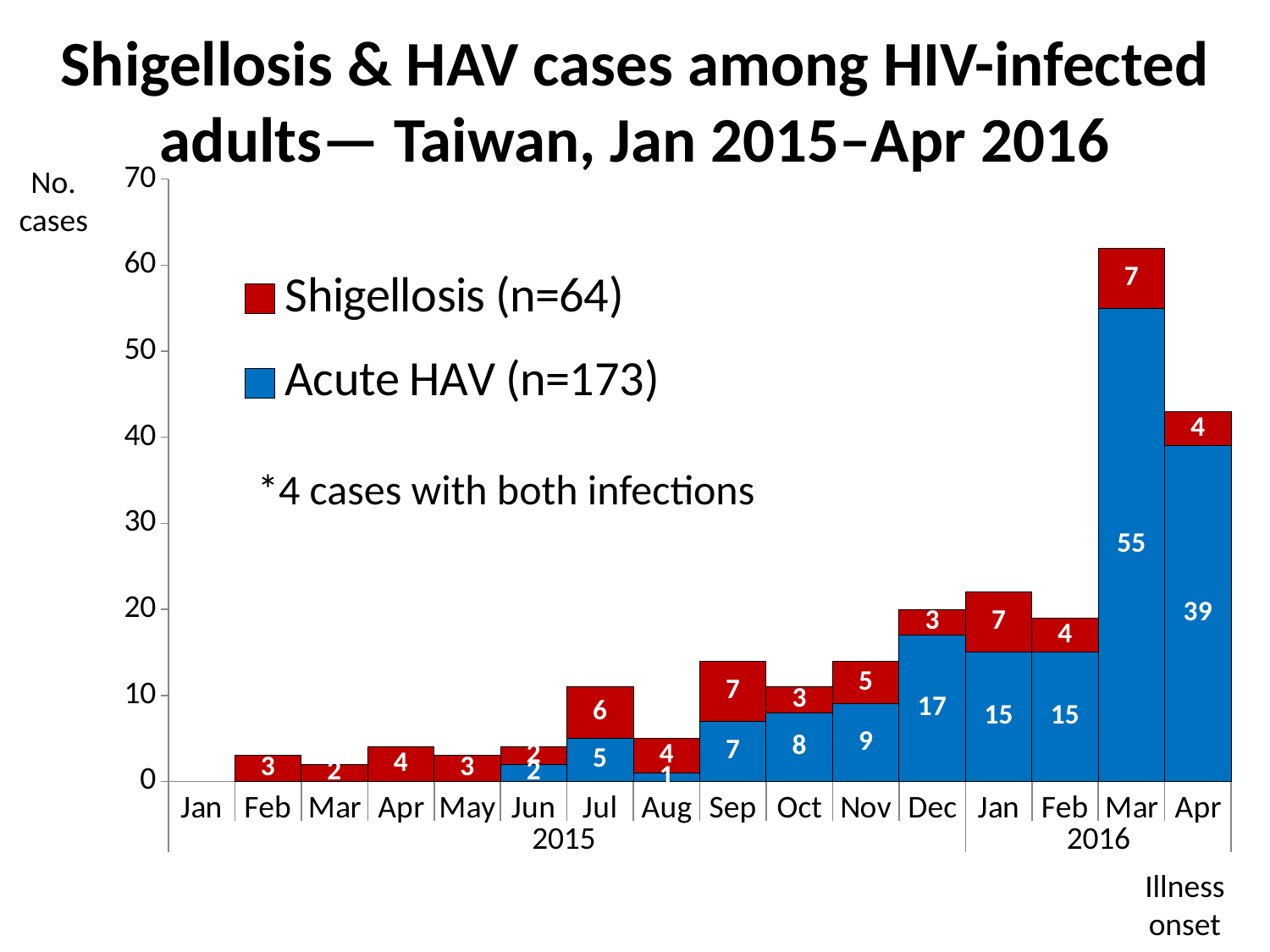
What type of chart is shown on the slide? Stacked bar chart What is the difference between the Acute HAV cases in Mar 2016 and Apr 2016? 16 How many Shigellosis cases had illness onset in Jul 2015? 6 How many series does the legend list? 2 Which month has the highest number of Acute HAV cases? Mar 2016 What is the total number of cases (Shigellosis plus Acute HAV) in Mar 2016? 62 What is the total number of cases (Shigellosis plus Acute HAV) in Apr 2016? 43 How many Acute HAV cases had illness onset in Dec 2015? 17 Is the total number of cases in Mar 2016 greater or less than 60? greater According to the legend, what is the total number of Acute HAV cases (n)? 173 How many Acute HAV cases had illness onset in Mar 2016? 55 Which is larger in Nov 2015: the number of Shigellosis cases or the number of Acute HAV cases? Acute HAV